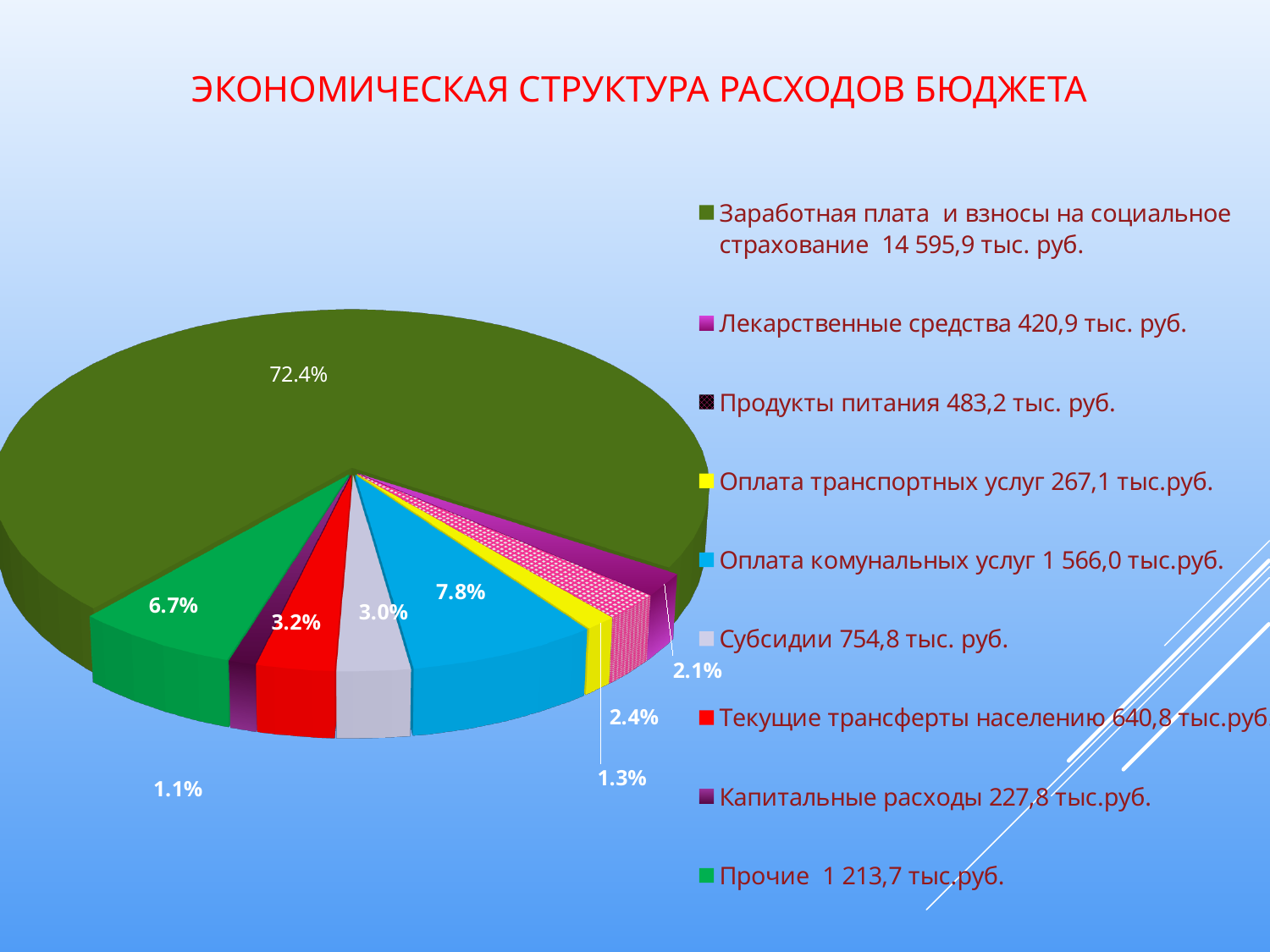
Which category has the largest slice of the pie? Заработная плата и взносы на социальное страхование What percentage is shown for Прочие? 6.7% What percentage is shown for Капитальные расходы? 1.1% What is the difference in percentage points between the Оплата комунальных услуг slice (7.8%) and the Прочие slice (6.7%)? 1.1 Which category has the smallest slice of the pie? Капитальные расходы What is the title of the chart? ЭКОНОМИЧЕСКАЯ СТРУКТУРА РАСХОДОВ БЮДЖЕТА What type of chart is shown on the slide? pie chart How many categories does the legend list? 9 According to the legend, what amount is given for Лекарственные средства? 420,9 тыс. руб. What share of the pie is labelled for Заработная плата и взносы на социальное страхование? 72.4% What percentage is shown for Оплата комунальных услуг? 7.8% Which is larger, the share for Текущие трансферты населению or the share for Субсидии? Текущие трансферты населению